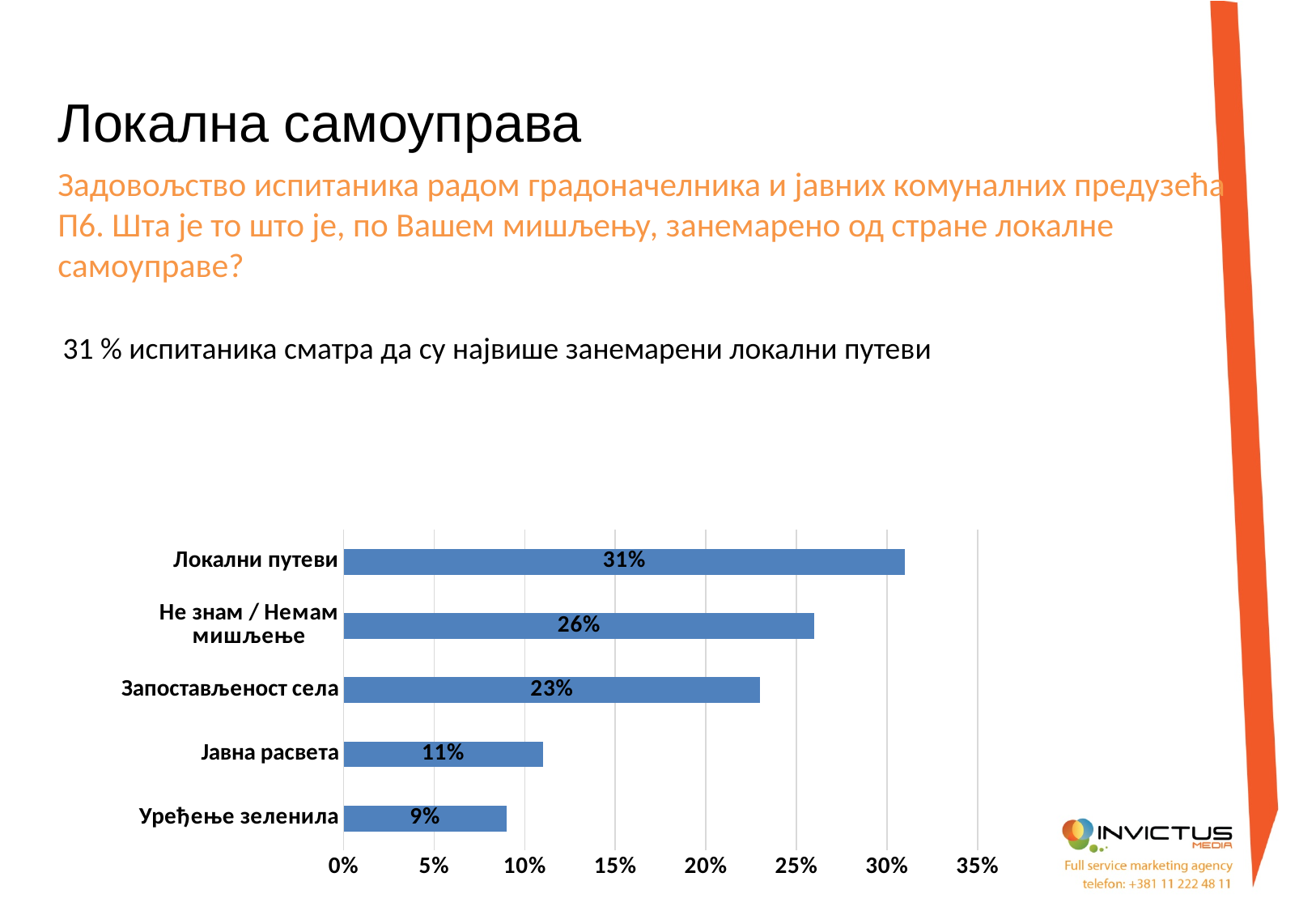
What is the value for Јавна расвета? 11% Which category has the highest value? Локални путеви What is the value for Запостављеност села? 23% What kind of chart is shown on the slide? Bar chart Is the value for Не знам / Немам мишљење greater or less than 25%? greater How many categories are shown in the chart? 5 What is the value for Локални путеви? 31% What is the value for Уређење зеленила? 9% Which category has the lowest value? Уређење зеленила Which is larger, the value for Јавна расвета or the value for Уређење зеленила? Јавна расвета What is the difference between the values for Локални путеви and Запостављеност села? 8% What is the value for Не знам / Немам мишљење? 26%